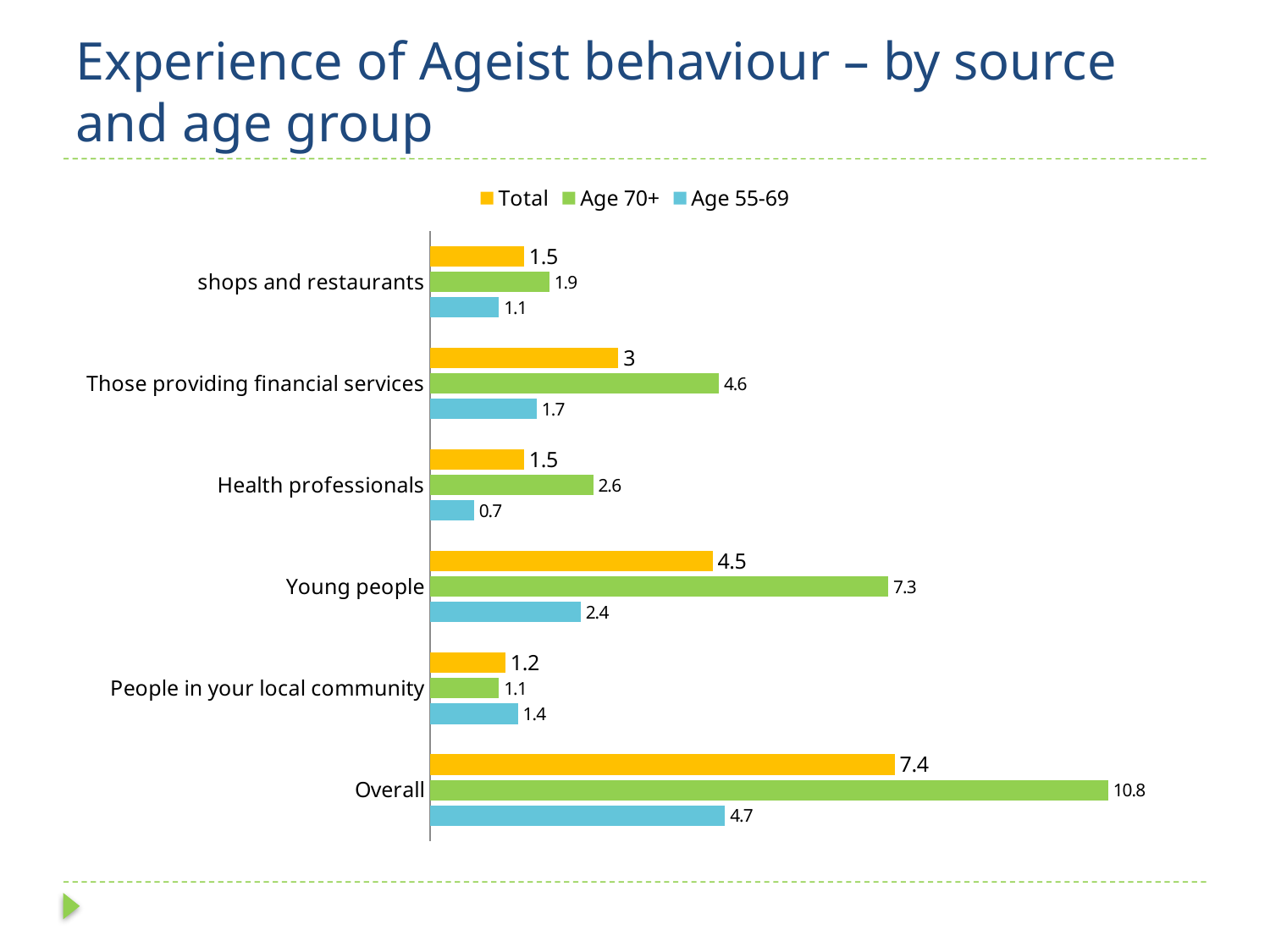
How many categories are shown on the chart? 6 What is the Age 70+ value for Young people? 7.3 What is the Total value for Those providing financial services? 3 How many series does the legend list? 3 What kind of chart is shown on the slide? Bar chart Which category has the lowest Age 70+ value? People in your local community Which is larger for People in your local community: the Total value or the Age 55-69 value? Age 55-69 What is the difference between the Age 70+ and Age 55-69 values for Overall? 6.1 What is the Age 70+ value for Overall? 10.8 What is the Age 55-69 value for Health professionals? 0.7 Which colour represents the Age 70+ series in the legend? Green Which category has the highest Age 55-69 value? Overall